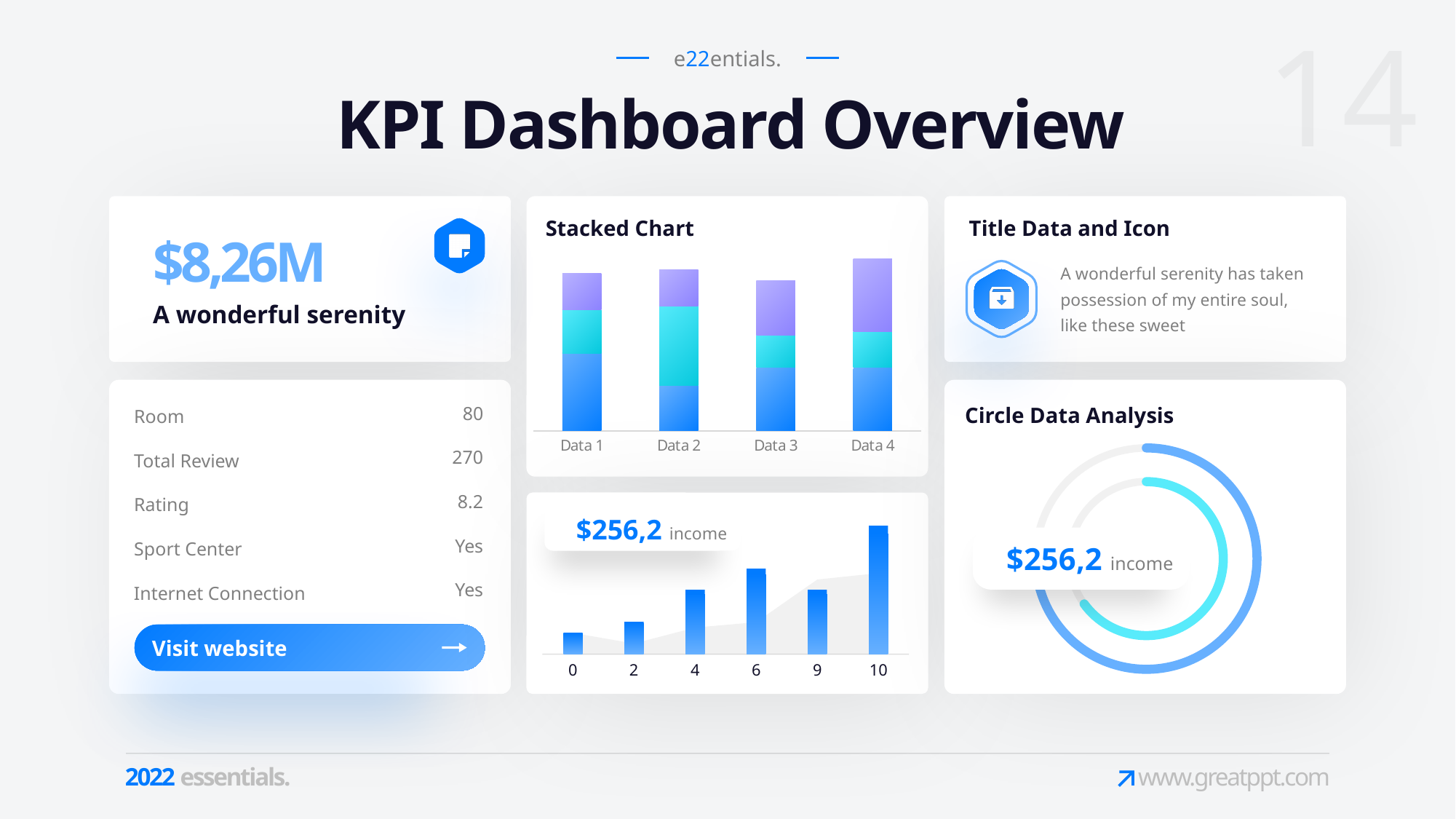
In the income bar chart in the bottom middle panel, do the bars generally rise or fall from left to right? Rise In the income bar chart in the bottom middle panel, which x-axis category has the shortest bar? 0 What kind of chart is the "Stacked Chart"? Stacked bar chart In the "Stacked Chart", which bar is taller overall, Data 1 or Data 4? Data 4 In the income bar chart in the bottom middle panel, which bar is taller, the one at 6 or the one at 9? 6 How many bars are in the income bar chart in the bottom middle panel? 6 How many categories are shown on the x axis of the "Stacked Chart"? 4 What income value is printed on the label in the "Circle Data Analysis" panel? $256,2 How many stacked segments does each bar in the "Stacked Chart" have? 3 In the income bar chart in the bottom middle panel, which x-axis category has the tallest bar? 10 What kind of chart is the income chart in the bottom middle panel? Combination bar and area chart In the "Stacked Chart", which category has the tallest bar overall? Data 4